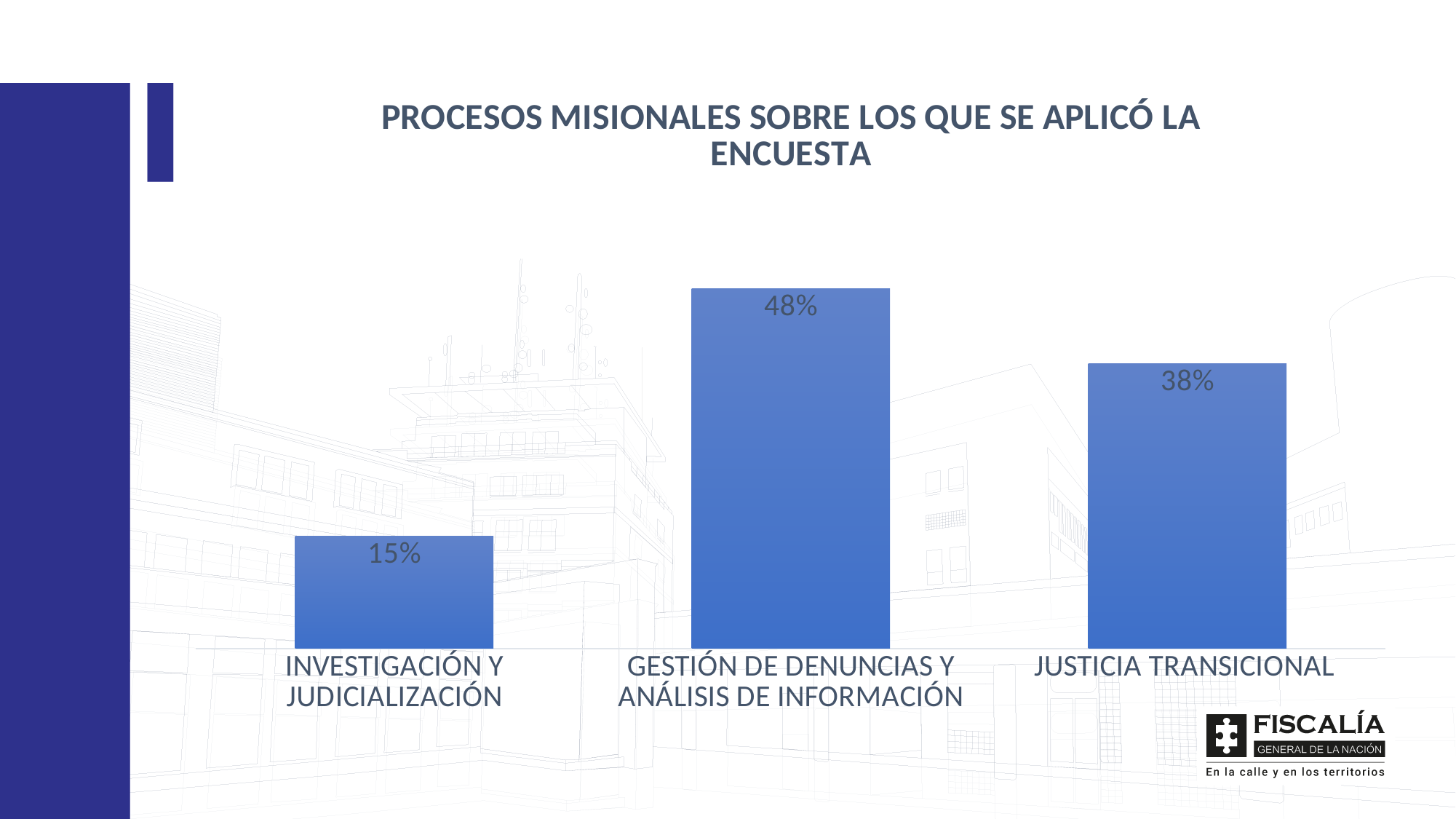
What is the title of the chart? PROCESOS MISIONALES SOBRE LOS QUE SE APLICÓ LA ENCUESTA How many categories are shown in the chart? 3 What kind of chart is shown on the slide? Bar chart What is the difference between the values for GESTIÓN DE DENUNCIAS Y ANÁLISIS DE INFORMACIÓN and JUSTICIA TRANSICIONAL? 10% What is the value for JUSTICIA TRANSICIONAL? 38% What is the value for INVESTIGACIÓN Y JUDICIALIZACIÓN? 15% Which category has the lowest value? INVESTIGACIÓN Y JUDICIALIZACIÓN What is the value for GESTIÓN DE DENUNCIAS Y ANÁLISIS DE INFORMACIÓN? 48% What is the total of the three values shown in the chart? 101% Which category has the highest value? GESTIÓN DE DENUNCIAS Y ANÁLISIS DE INFORMACIÓN Which is larger, the value for JUSTICIA TRANSICIONAL or the value for INVESTIGACIÓN Y JUDICIALIZACIÓN? JUSTICIA TRANSICIONAL What is the difference between the values for JUSTICIA TRANSICIONAL and INVESTIGACIÓN Y JUDICIALIZACIÓN? 23%